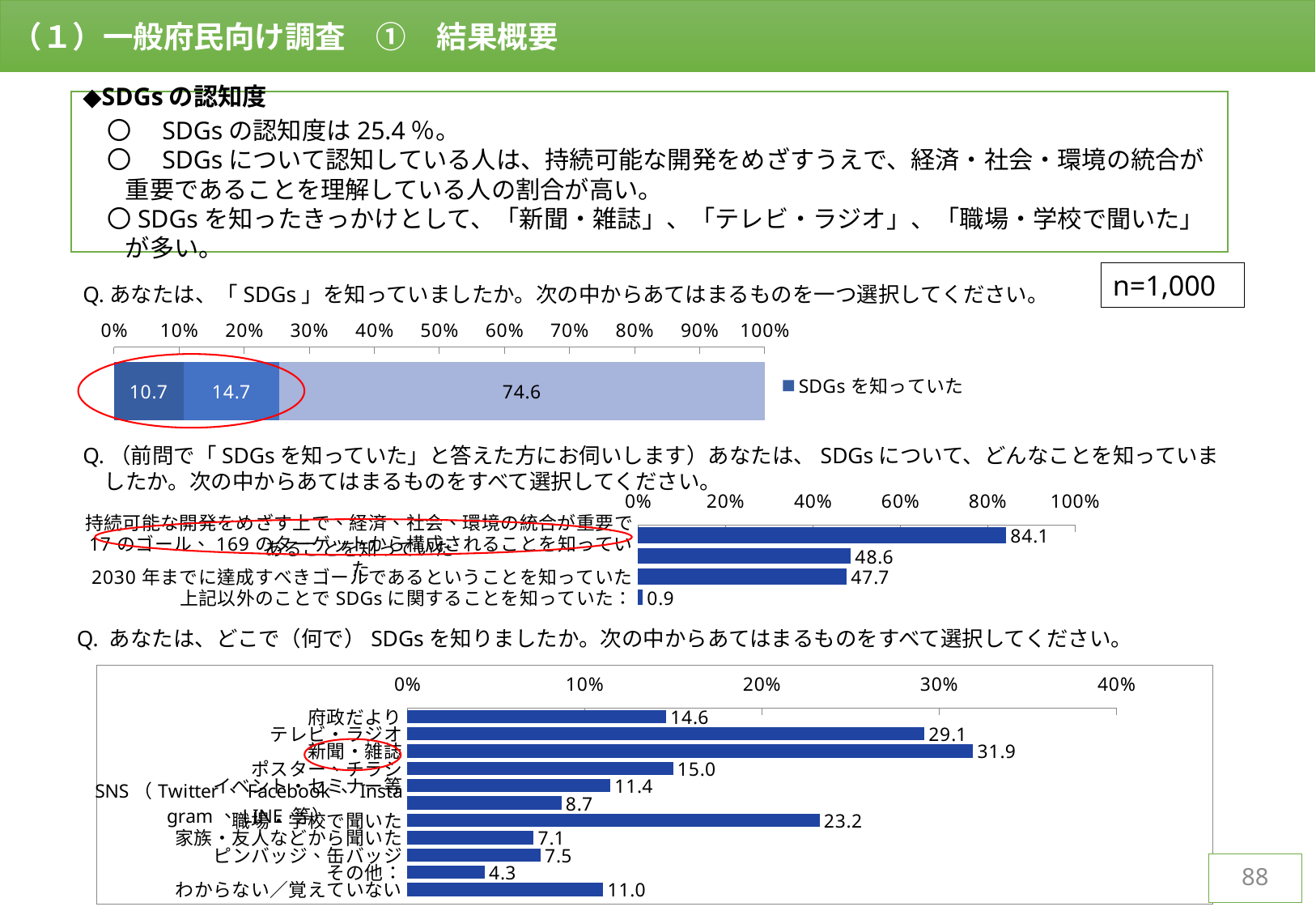
In the bottom chart (where people learned about SDGs), which is larger: 府政だより or わからない／覚えていない? 府政だより In the bottom chart (where people learned about SDGs), which category has the lowest value? その他 In the top chart (whether respondents knew SDGs), what is the value of the largest segment? 74.6 In the middle chart (what respondents knew about SDGs), what is the value for 上記以外のことでSDGsに関することを知っていた? 0.9 In the bottom chart (where people learned about SDGs), which category has the highest value? 新聞・雑誌 What type of chart is the bottom chart (where people learned about SDGs)? Bar chart In the bottom chart (where people learned about SDGs), how many bars are plotted? 11 In the bottom chart (where people learned about SDGs), what is the difference between 新聞・雑誌 and テレビ・ラジオ? 2.8 In the top chart (whether respondents knew SDGs), what is the total of the three segments? 100.0 In the bottom chart (where people learned about SDGs), what is the value for 新聞・雑誌? 31.9 In the bottom chart (where people learned about SDGs), what is the value for テレビ・ラジオ? 29.1 In the bottom chart (where people learned about SDGs), what is the value for 職場・学校で聞いた? 23.2